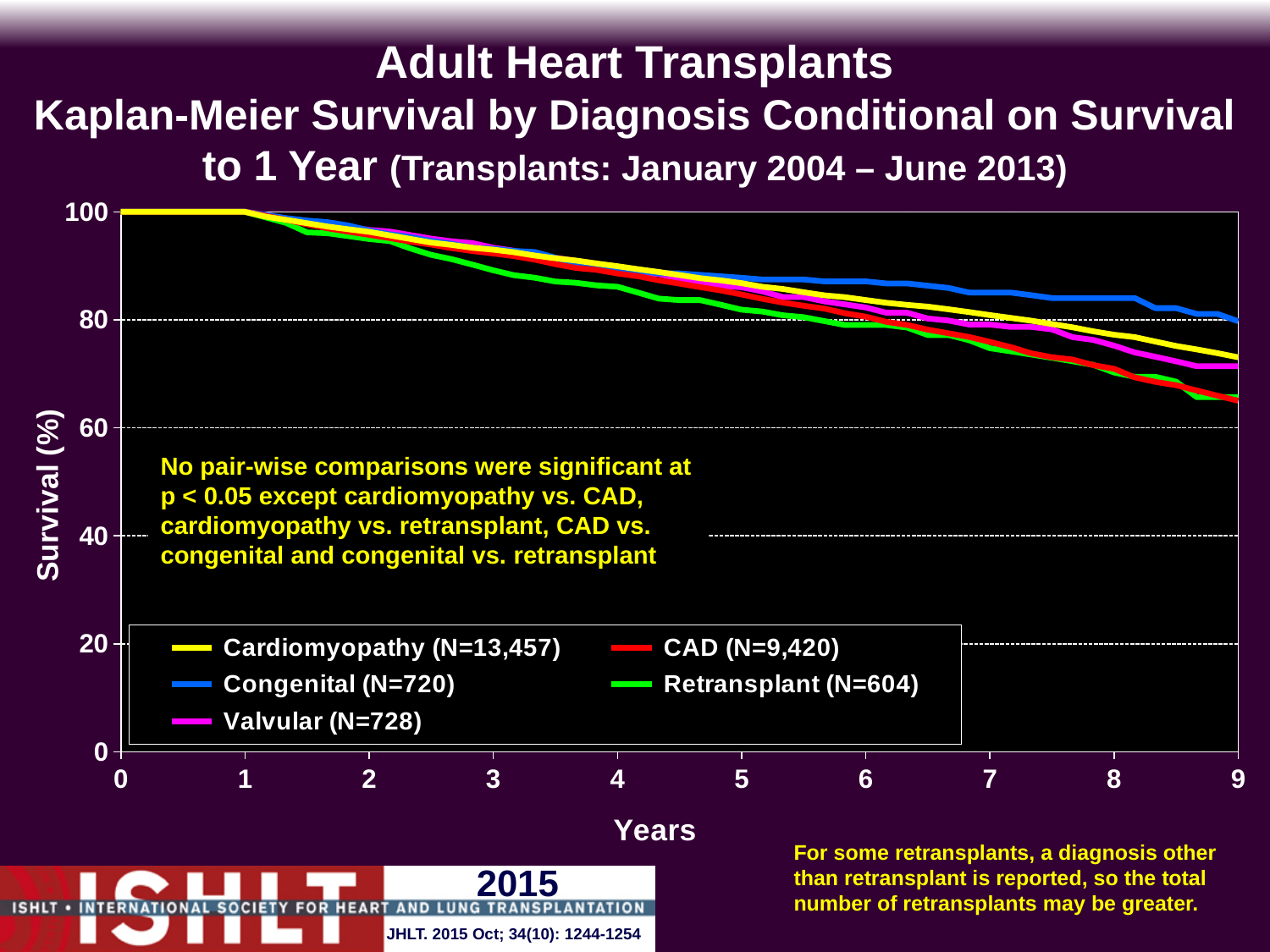
Which diagnosis group has the lowest survival at 3 years? Retransplant Which diagnosis group has the highest survival at 9 years? Congenital How many series does the legend list? 5 Is the survival for Cardiomyopathy at 9 years greater or less than 80? less Is the survival for Congenital at 7 years greater or less than 80? greater Do the survival curves rise or fall as years increase? Fall At 7 years, which has higher survival: Congenital or Retransplant? Congenital What is the N for the Cardiomyopathy group shown in the legend? N=13,457 Is the survival for Retransplant at 9 years greater or less than 80? less At 9 years, which has higher survival: Congenital or Cardiomyopathy? Congenital What kind of chart is shown on the slide? Line chart